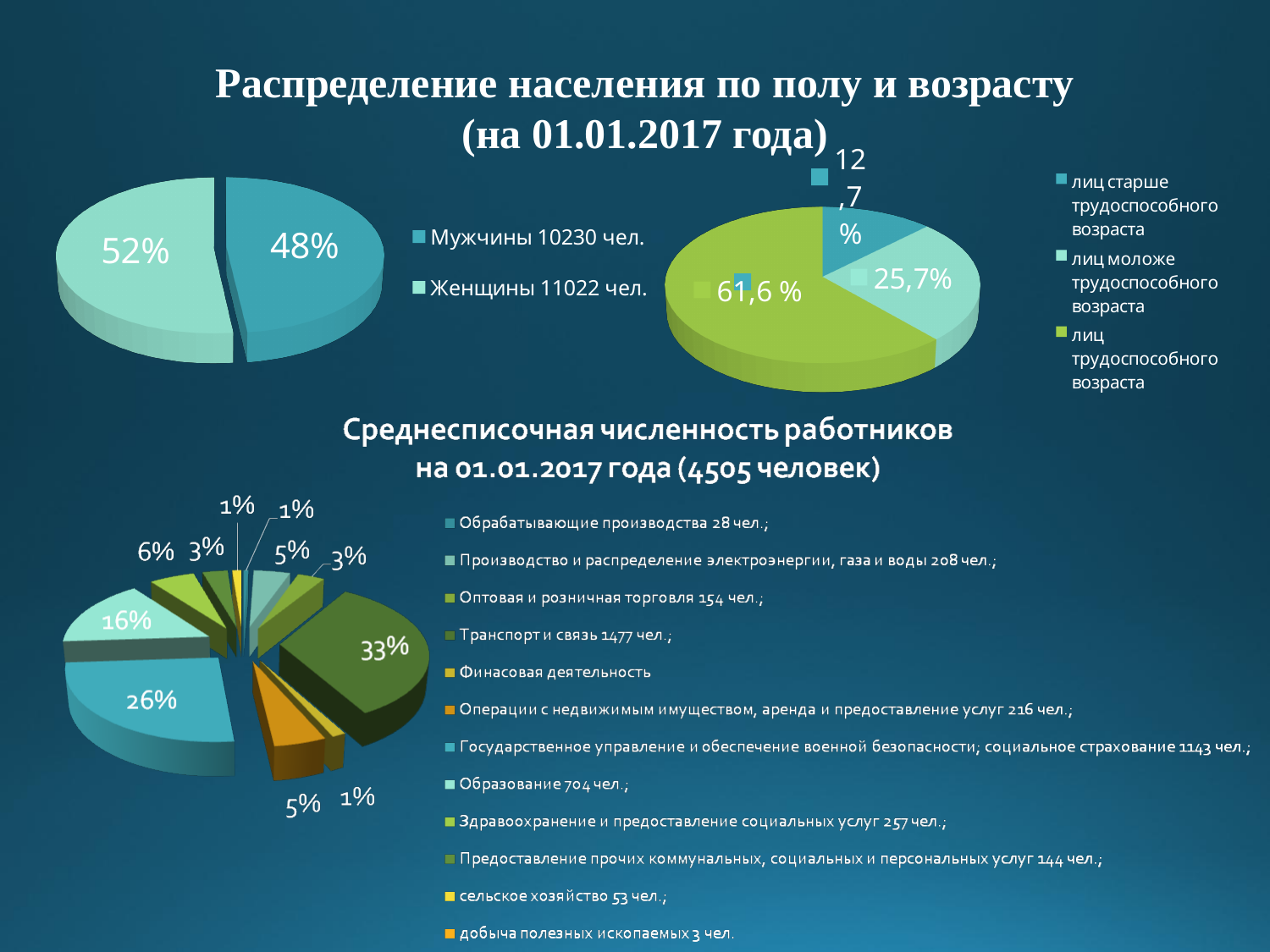
What kind of chart is the bottom chart (Среднесписочная численность работников)? pie chart In the top-left pie chart, what share is shown for Мужчины? 48% In the top-left pie chart, how many people does the legend give for Мужчины? 10230 чел. In the top-right pie chart, what share is shown for лиц трудоспособного возраста? 61,6 % In the top-right pie chart, what share is shown for лиц моложе трудоспособного возраста? 25,7% In the bottom pie chart (Среднесписочная численность работников), how many entries does the legend list? 12 In the top-right pie chart, how many slices are there? 3 In the top-right pie chart, which category has the smallest slice? лиц старше трудоспособного возраста In the top-left pie chart, which slice is larger, Мужчины or Женщины? Женщины In the top-right pie chart, what is the difference in percentage points between лиц трудоспособного возраста and лиц моложе трудоспособного возраста? 35,9 In the bottom pie chart (Среднесписочная численность работников), what is the share of the largest slice? 33%